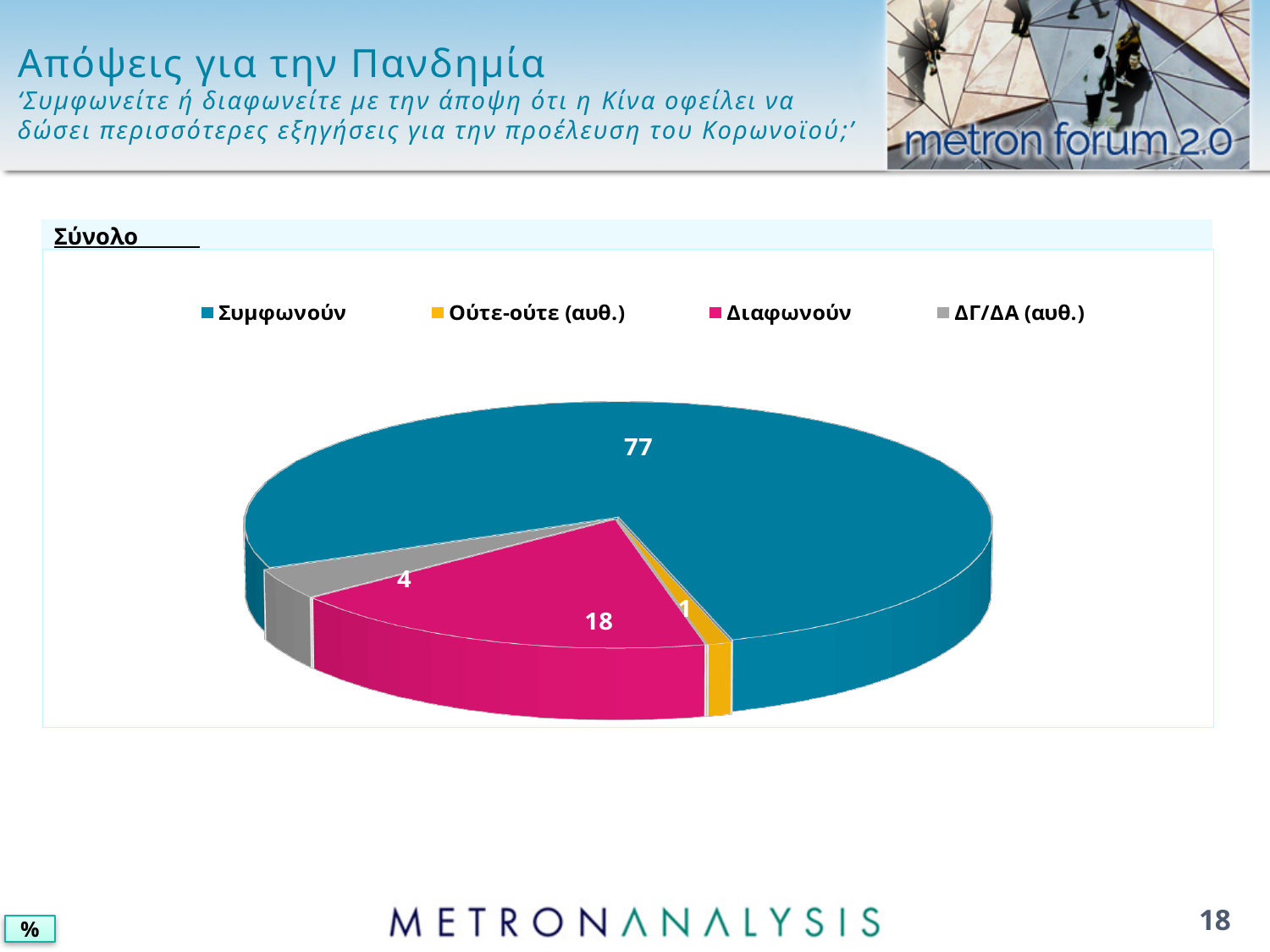
What is the value for Συμφωνούν? 77 What is the difference between the values for Συμφωνούν and Διαφωνούν? 59 What kind of chart is shown on the slide? pie chart What is the value for Ούτε-ούτε (αυθ.)? 1 Which category has the smallest slice of the pie? Ούτε-ούτε (αυθ.) Which is larger, the value for Διαφωνούν or the value for ΔΓ/ΔΑ (αυθ.)? Διαφωνούν What colour is the slice for Διαφωνούν? magenta How many slices does the pie chart have? 4 What is the value for Διαφωνούν? 18 Which category has the largest slice of the pie? Συμφωνούν How many entries does the legend list? 4 What is the value for ΔΓ/ΔΑ (αυθ.)? 4